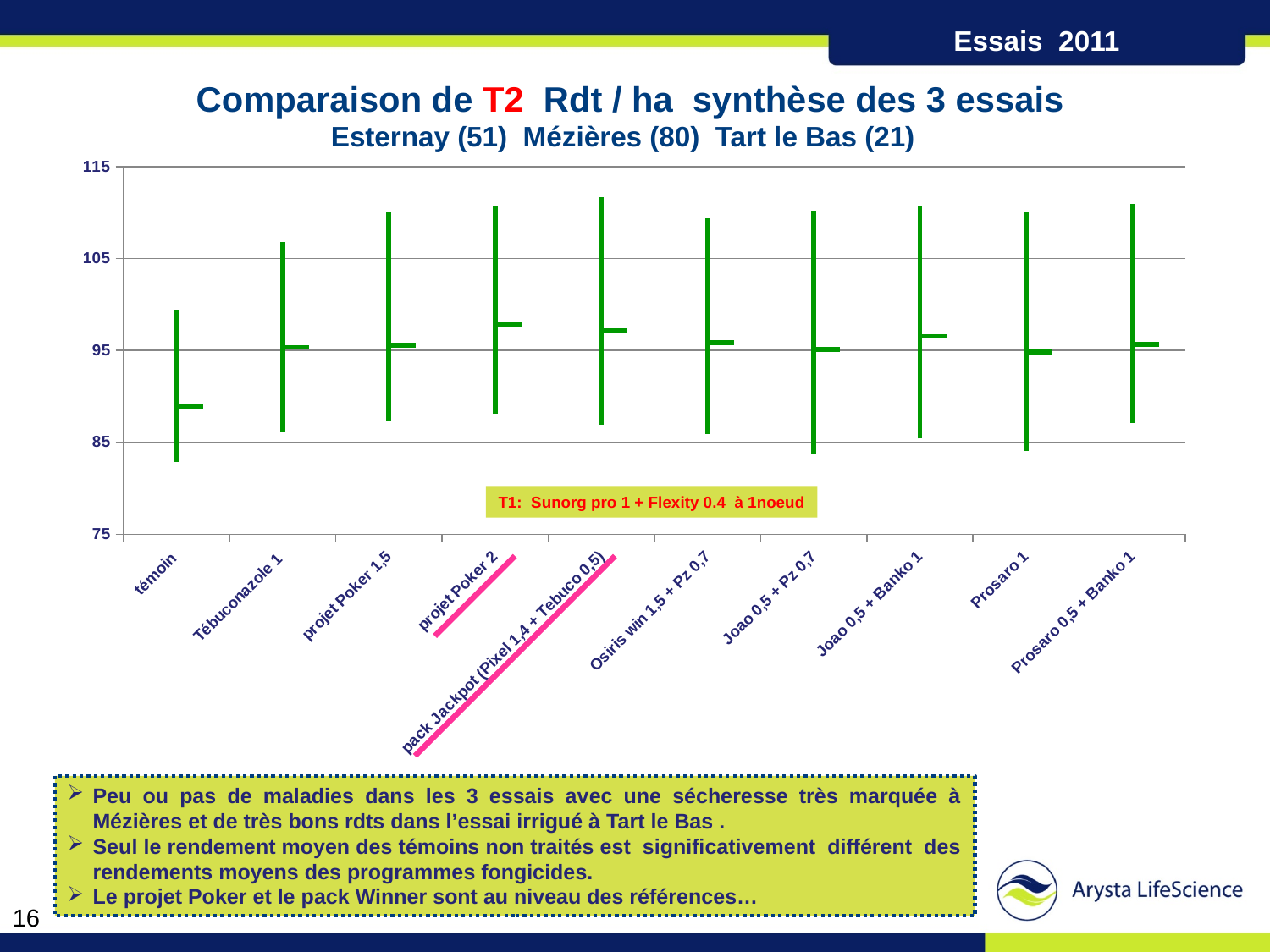
Which category has the lowest mean (horizontal tick) in the chart? témoin Is the lower end of the vertical line for témoin greater or less than 85? less How many treatment categories are shown along the x axis of the chart? 10 Which has the larger mean value (horizontal tick): témoin or Tébuconazole 1? Tébuconazole 1 What kind of chart is shown on the slide? High-low (stock-style) chart with vertical range lines and mean ticks What is the highest value shown on the y axis of the chart? 115 Is the upper end of the vertical line for témoin greater or less than 105? less Is the mean value (horizontal tick) for témoin greater or less than 95? less What is the title of the chart on the slide? Comparaison de T2 Rdt / ha synthèse des 3 essais